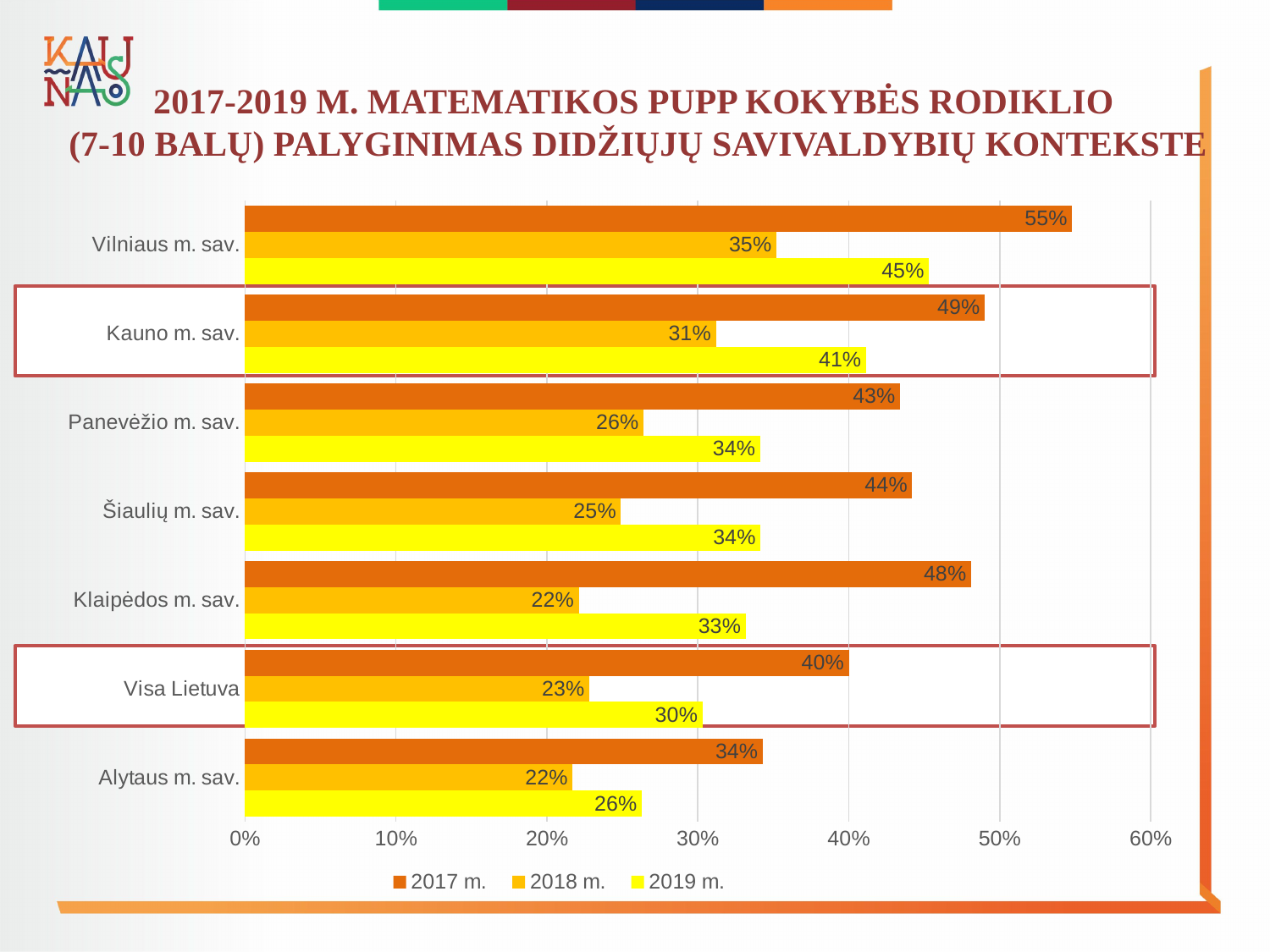
Which series is shown in yellow in the legend? 2019 m. How many series does the legend list? 3 How many categories are shown on the chart? 7 Which category has the lowest value in 2019 m.? Alytaus m. sav. What is the value for Visa Lietuva in 2019 m.? 30% What kind of chart is shown on the slide? Bar chart What is the difference between the 2017 m. and 2018 m. values for Vilniaus m. sav.? 20% Which is larger for Klaipėdos m. sav.: the 2017 m. value or the 2019 m. value? 2017 m. Which category has the highest value in 2017 m.? Vilniaus m. sav. What is the value for Alytaus m. sav. in 2018 m.? 22% What is the value for Kauno m. sav. in 2017 m.? 49% What is the difference between the 2019 m. values for Kauno m. sav. and Visa Lietuva? 11%